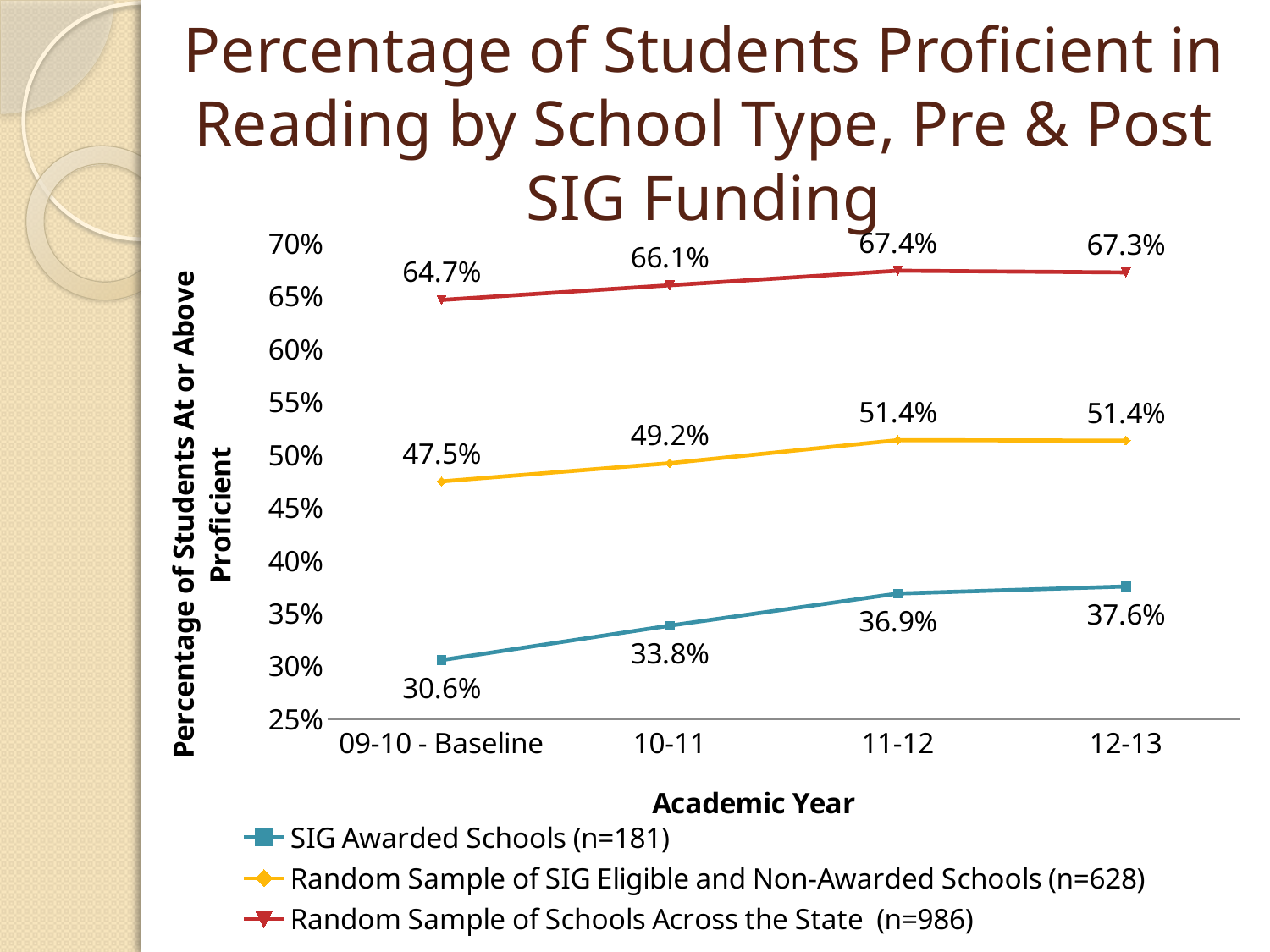
In which academic year did the Random Sample of Schools Across the State have its lowest value? 09-10 - Baseline Does the SIG Awarded Schools series rise or fall from 09-10 - Baseline to 12-13? rise Is the value for SIG Awarded Schools in 11-12 greater or less than 40%? less What was the value for the Random Sample of SIG Eligible and Non-Awarded Schools in 10-11? 49.2% What percentage of students in SIG Awarded Schools were proficient in reading in 09-10 - Baseline? 30.6% What was the value for the Random Sample of Schools Across the State in 11-12? 67.4% In which academic year did SIG Awarded Schools have their highest reading proficiency percentage? 12-13 How many academic years are shown on the x axis? 4 What kind of chart is shown on the slide? line chart Which series had the higher value in 12-13: SIG Awarded Schools or the Random Sample of SIG Eligible and Non-Awarded Schools? Random Sample of SIG Eligible and Non-Awarded Schools How many series does the legend list? 3 What is the difference between the SIG Awarded Schools value in 12-13 and in 09-10 - Baseline? 7.0%